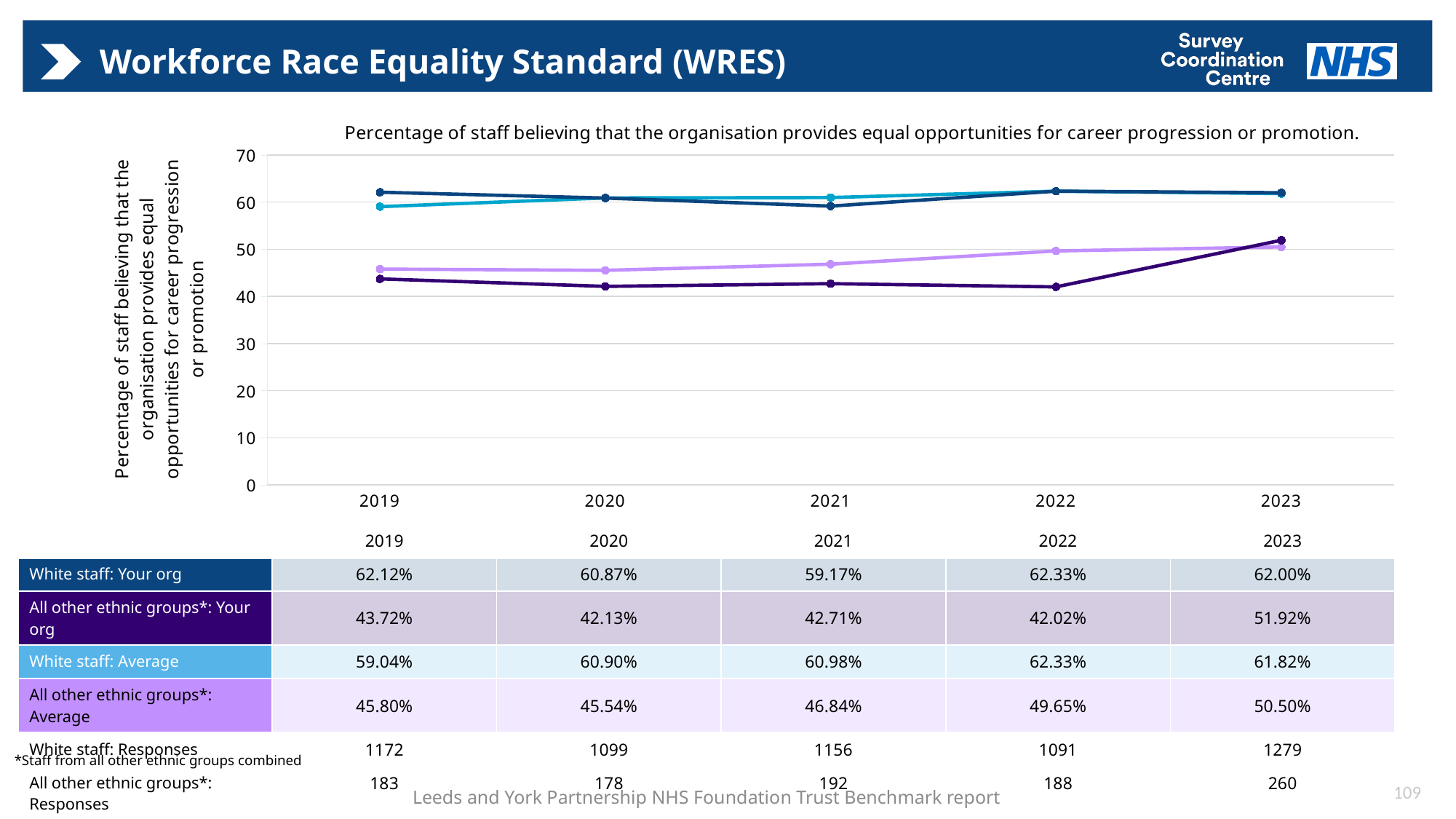
What is the value for White staff: Your org in 2021? 59.17% In which year is the value for White staff: Your org lowest? 2021 Does the value for All other ethnic groups*: Average rise or fall from 2020 to 2023? Rise What is the difference between White staff: Your org and All other ethnic groups*: Your org in 2023? 10.08 percentage points Is the value for All other ethnic groups*: Your org in 2019 greater or less than 40? greater In which year is the value for All other ethnic groups*: Your org highest? 2023 How many data series are plotted in the chart? 4 What kind of chart is shown on the slide? Line chart How many years are plotted along the x axis of the chart? 5 What is the value for All other ethnic groups*: Your org in 2023? 51.92% What is the title of the chart? Percentage of staff believing that the organisation provides equal opportunities for career progression or promotion. In 2019, which is larger: White staff: Your org or White staff: Average? White staff: Your org